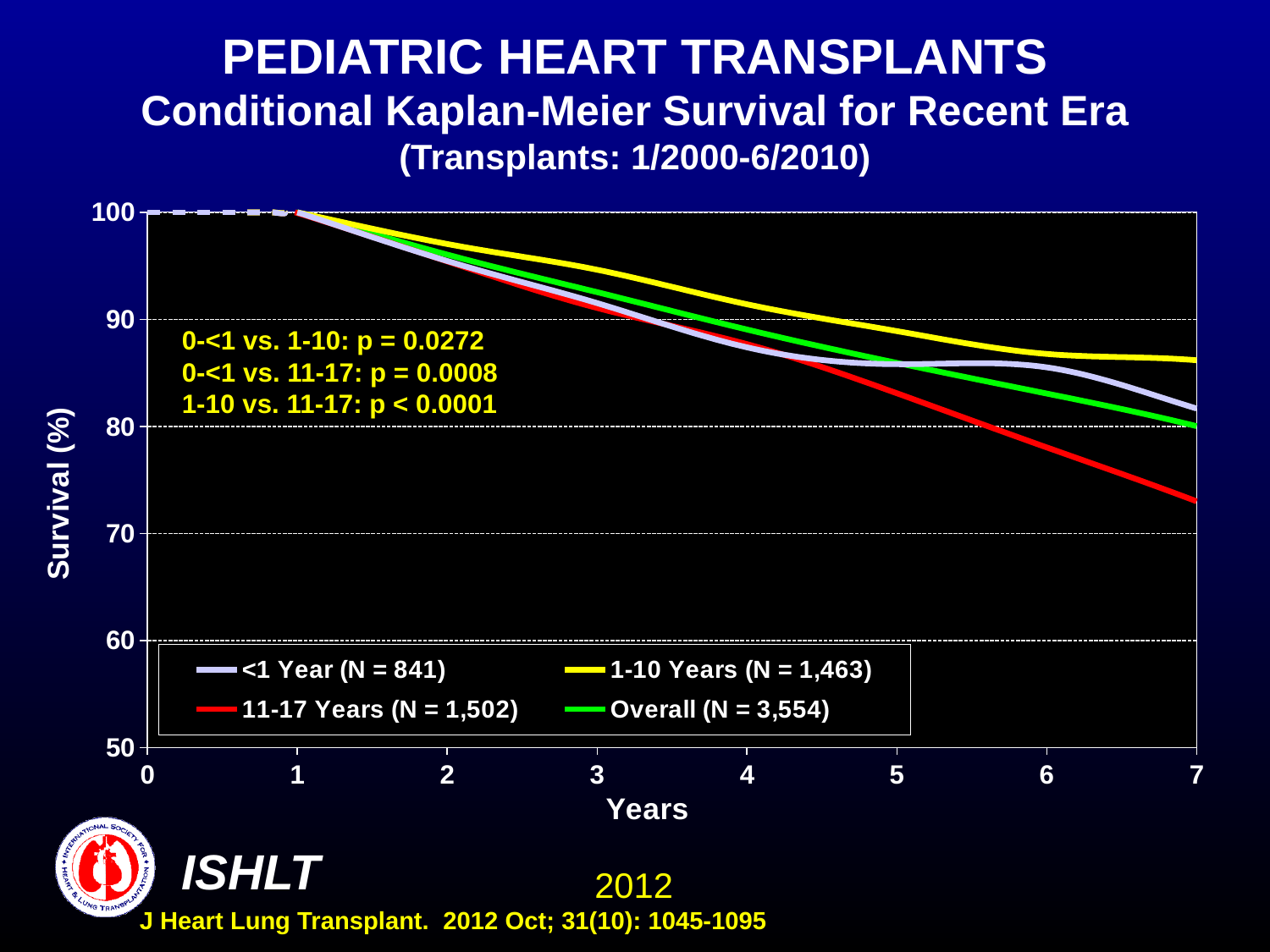
Do the survival curves rise or fall as years increase? fall Is the survival for the 1-10 Years group at 3 years greater or less than 90? greater How many series does the legend list? 4 Which series has the highest survival at 7 years? 1-10 Years What is the p-value shown for 0-<1 vs. 11-17? p = 0.0008 Is the survival for the 11-17 Years group at 7 years greater or less than 80? less What is the N for the Overall group in the legend? 3,554 At 7 years, is survival higher for the 1-10 Years group or the 11-17 Years group? 1-10 Years Which series has the lowest survival at 7 years? 11-17 Years Is the survival for the 11-17 Years group at 4 years greater or less than 90? less What kind of chart is shown on the slide? Line chart